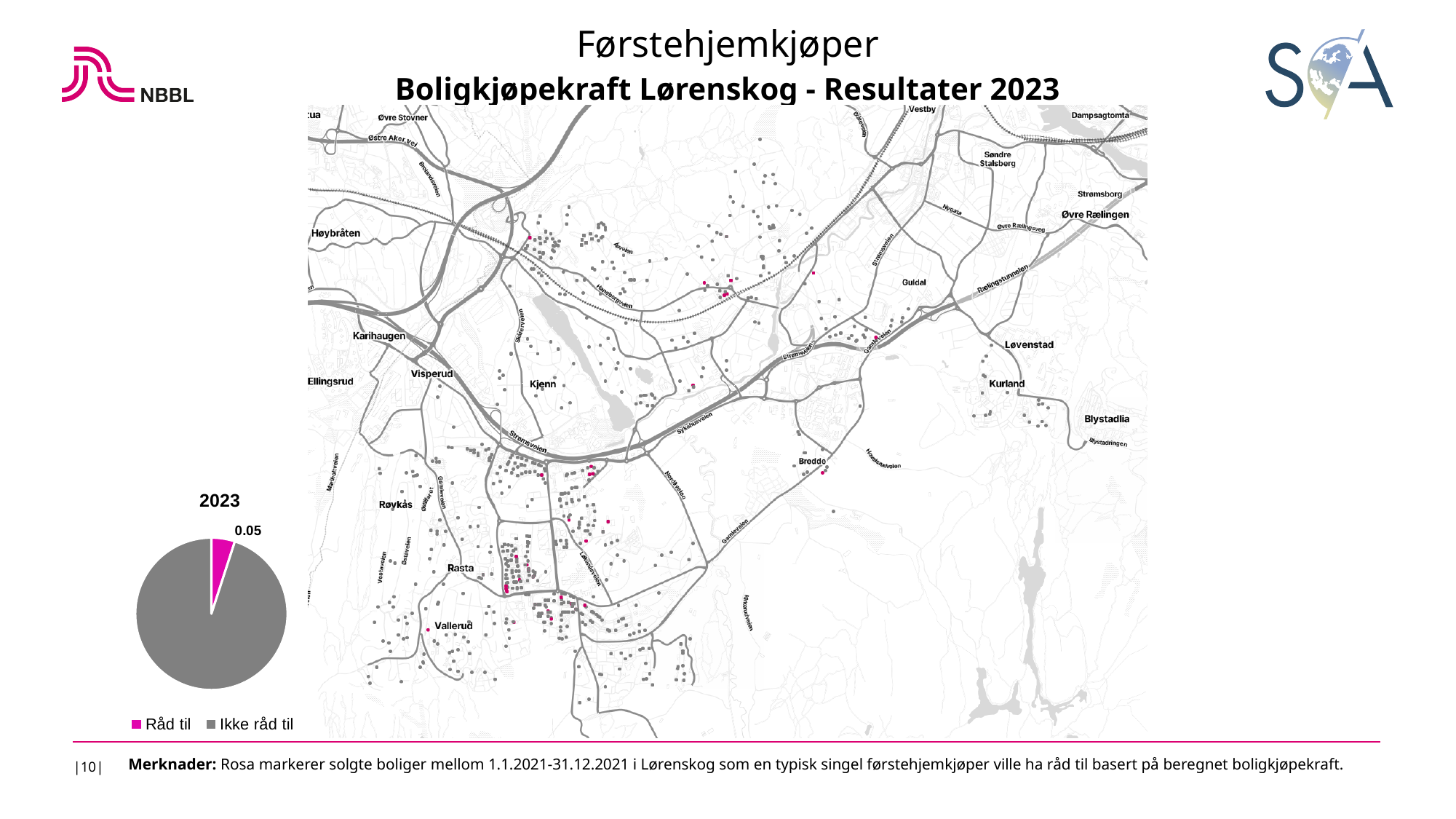
What value is labelled on the 'Råd til' slice of the pie chart? 0.05 What kind of chart is shown on the left of the slide? Pie chart Which slice of the pie chart is the smallest? Råd til In the pie chart, which is larger: 'Råd til' or 'Ikke råd til'? Ikke råd til What is the title of the pie chart? 2023 What share of the pie chart does the 'Råd til' slice represent, as labelled? 0.05 How many entries does the pie chart's legend list? 2 What colour is the 'Råd til' slice in the pie chart? Pink How many slices does the pie chart have? 2 Which slice of the pie chart is the largest? Ikke råd til